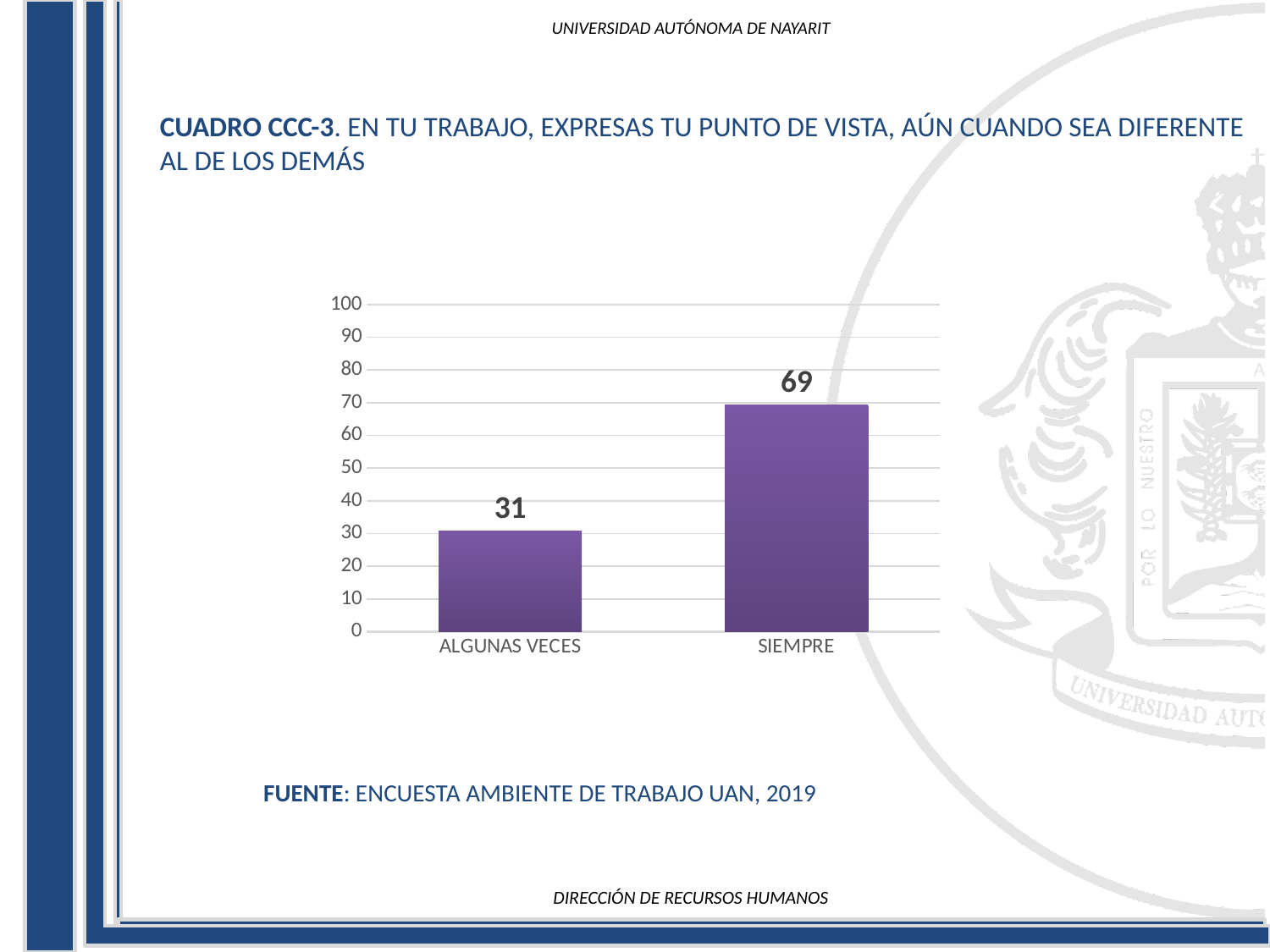
Is the value for SIEMPRE greater or less than 60? greater Which category has the highest value? SIEMPRE What is the difference between the values for SIEMPRE and ALGUNAS VECES? 38 Is the value for ALGUNAS VECES greater or less than 40? less What is the value for SIEMPRE? 69 What is the total of the two bar values? 100 What is the maximum value shown on the vertical axis? 100 What kind of chart is shown on the slide? bar chart Which category has the lowest value? ALGUNAS VECES How many categories are shown on the x axis? 2 What is the value for ALGUNAS VECES? 31 Which is larger, the value for ALGUNAS VECES or the value for SIEMPRE? SIEMPRE